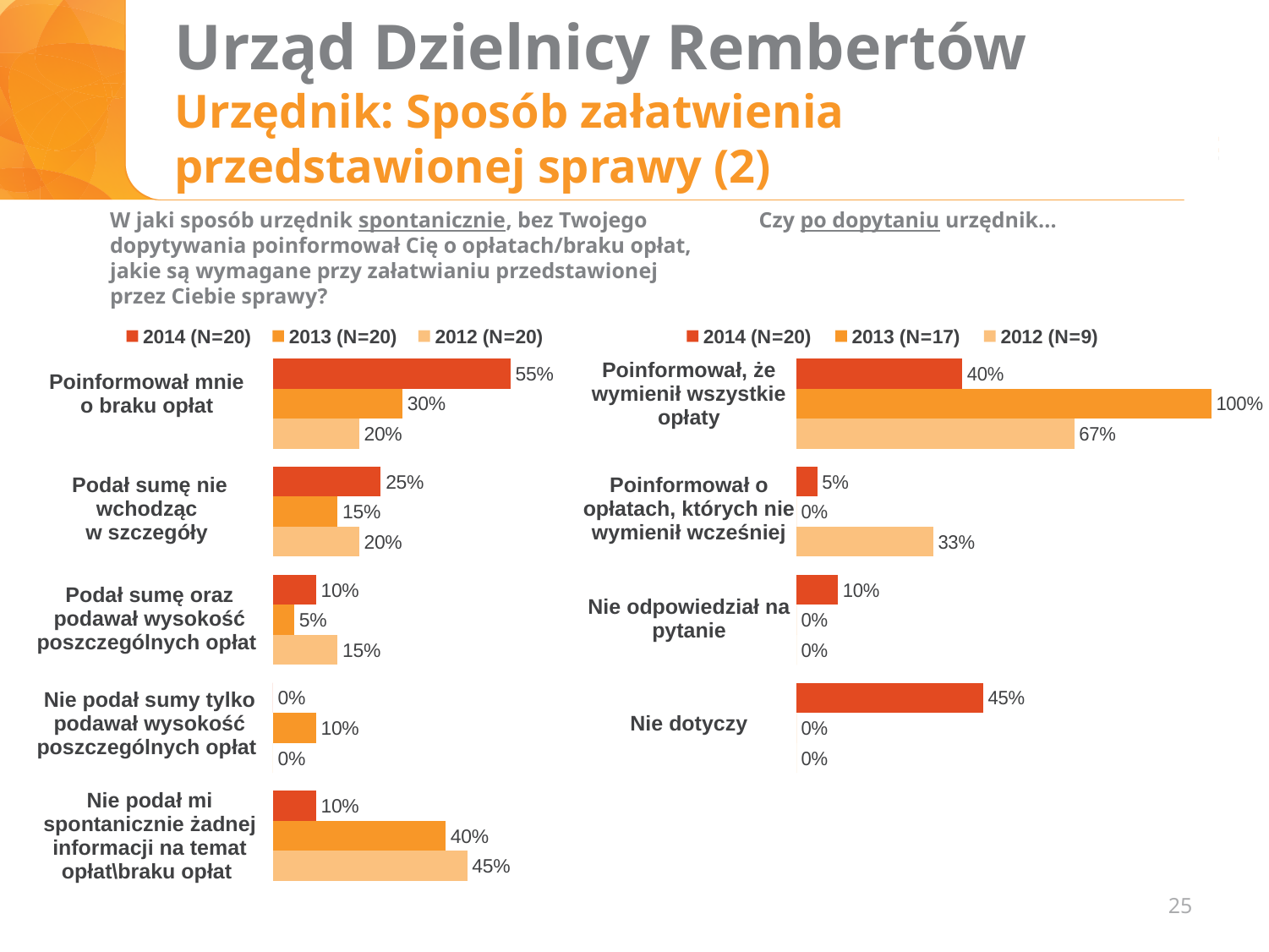
In the right chart, what is the 2012 value for "Poinformował o opłatach, których nie wymienił wcześniej"? 33% In the right chart, what is the difference between the 2013 and 2012 values for "Poinformował, że wymienił wszystkie opłaty"? 33 percentage points How many categories does the left chart show? 5 In the left chart (spontaneous information about fees), what is the 2014 value for "Poinformował mnie o braku opłat"? 55% In the left chart, what is the difference between the 2014 and 2013 values for "Poinformował mnie o braku opłat"? 25 percentage points In the right chart, which category has the highest 2014 value? Nie dotyczy How many series does the legend of the right chart list? 3 In the left chart, which is larger for "Podał sumę nie wchodząc w szczegóły": the 2014 value or the 2013 value? 2014 In the right chart ("Czy po dopytaniu urzędnik..."), what is the 2013 value for "Poinformował, że wymienił wszystkie opłaty"? 100% In the left chart, what is the 2013 value for "Nie podał mi spontanicznie żadnej informacji na temat opłat\braku opłat"? 40% What type of chart is used on the right side of the slide? Bar chart In the left chart, which category has the highest 2014 value? Poinformował mnie o braku opłat